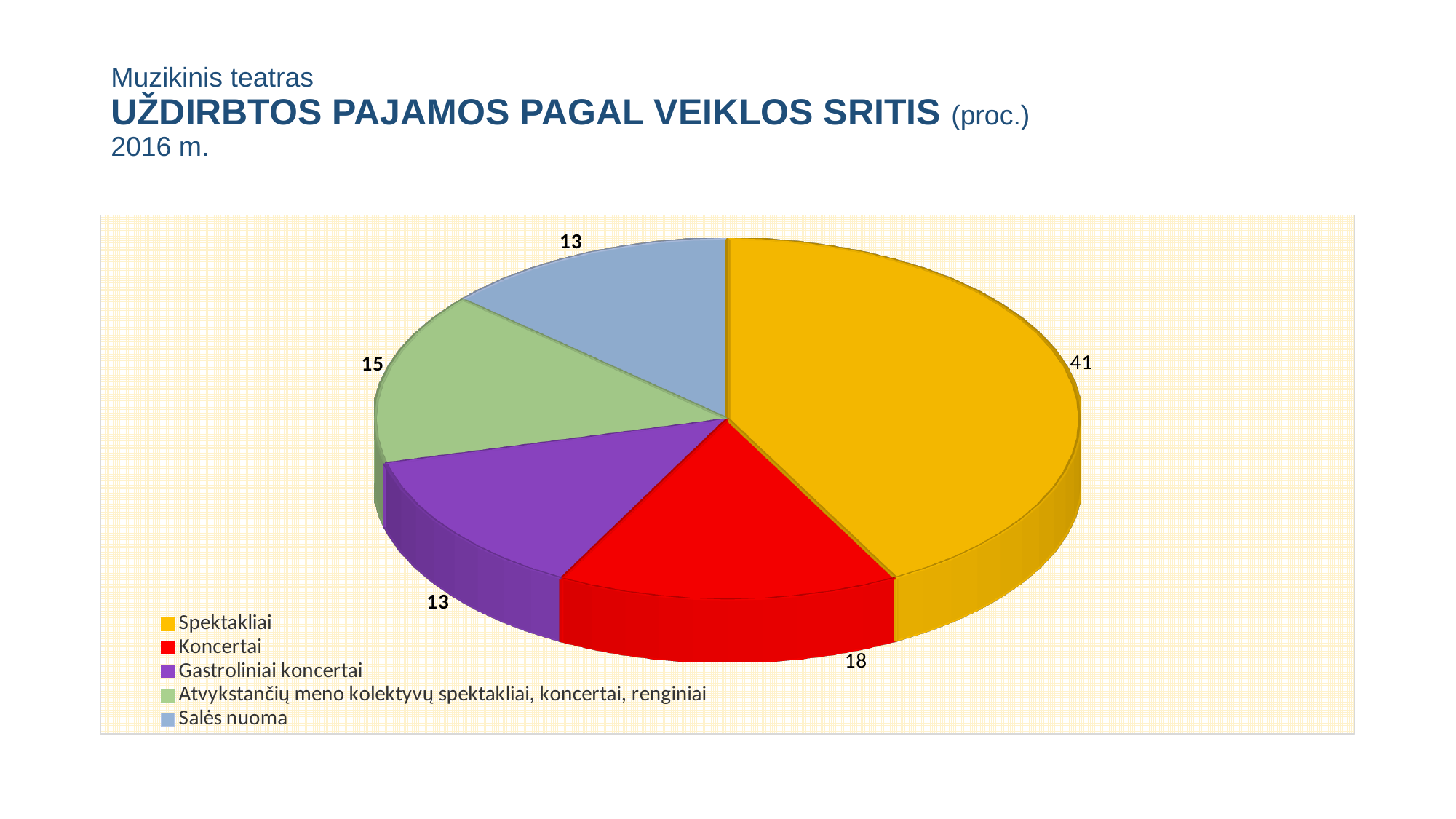
What is the value for Salės nuoma? 13 Which is larger, the value for Koncertai or the value for Atvykstančių meno kolektyvų spektakliai, koncertai, renginiai? Koncertai What is the value for Koncertai? 18 What is the value for Atvykstančių meno kolektyvų spektakliai, koncertai, renginiai? 15 How many categories does the pie chart have? 5 What is the total of all the slice values shown on the pie chart? 100 What is the difference between the values for Spektakliai and Koncertai? 23 What colour is the Salės nuoma slice? light blue Which category has the largest share of the pie? Spektakliai What is the value for Spektakliai? 41 What is the value for Gastroliniai koncertai? 13 What kind of chart is shown on the slide? pie chart